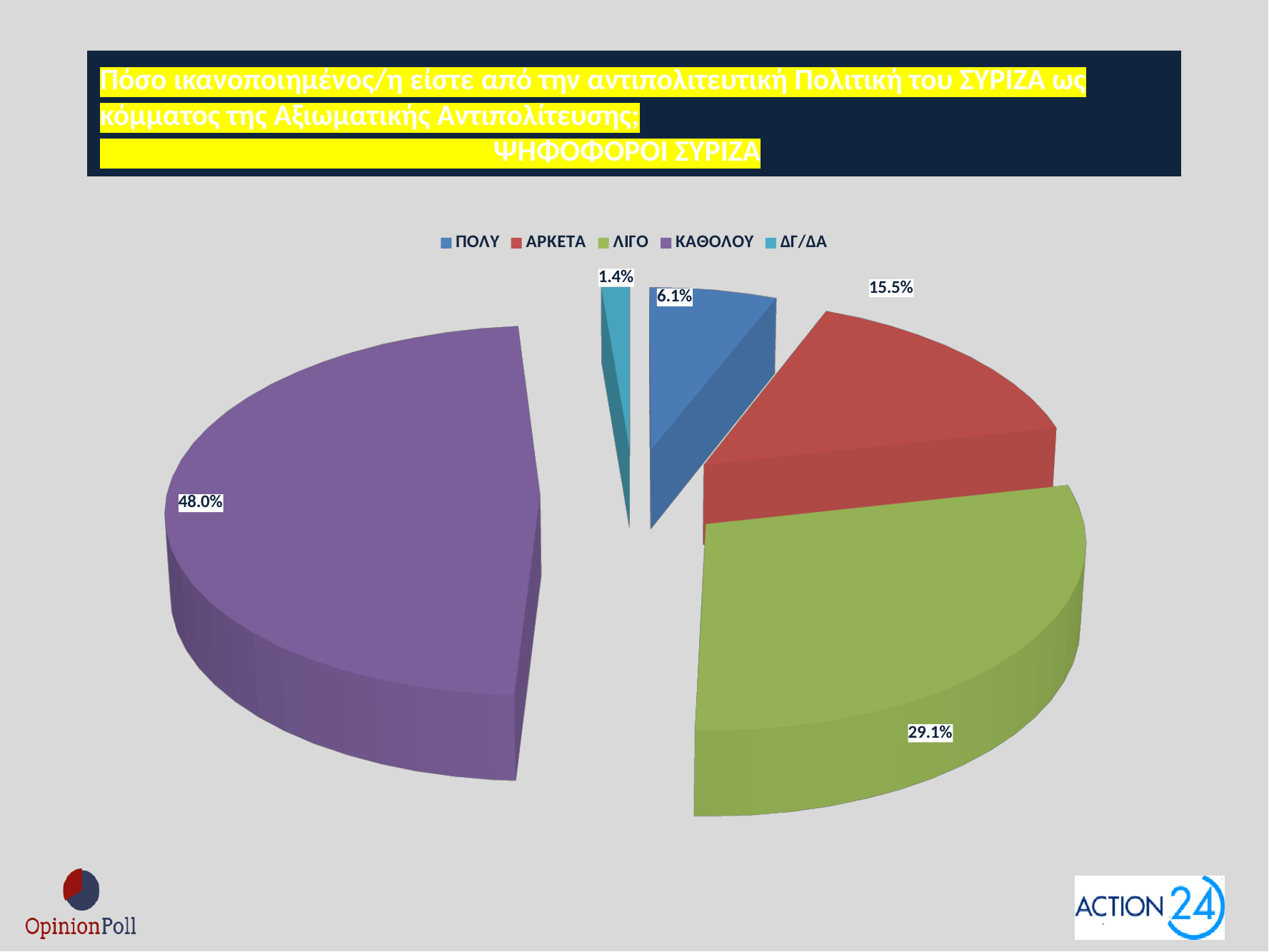
How many categories does the pie chart show? 5 What percentage of the pie is labelled ΔΓ/ΔΑ? 1.4% What colour is the ΛΙΓΟ slice in the pie chart? Green What percentage of the pie is labelled ΛΙΓΟ? 29.1% Which category has the smallest slice of the pie? ΔΓ/ΔΑ What percentage of the pie is labelled ΠΟΛΥ? 6.1% What is the difference in percentage points between ΚΑΘΟΛΟΥ and ΛΙΓΟ? 18.9 What kind of chart is shown on the slide? Pie chart What percentage of the pie is labelled ΚΑΘΟΛΟΥ? 48.0% What percentage of the pie is labelled ΑΡΚΕΤΑ? 15.5% Which category has the largest slice of the pie? ΚΑΘΟΛΟΥ Which is larger, the ΑΡΚΕΤΑ slice or the ΠΟΛΥ slice? ΑΡΚΕΤΑ